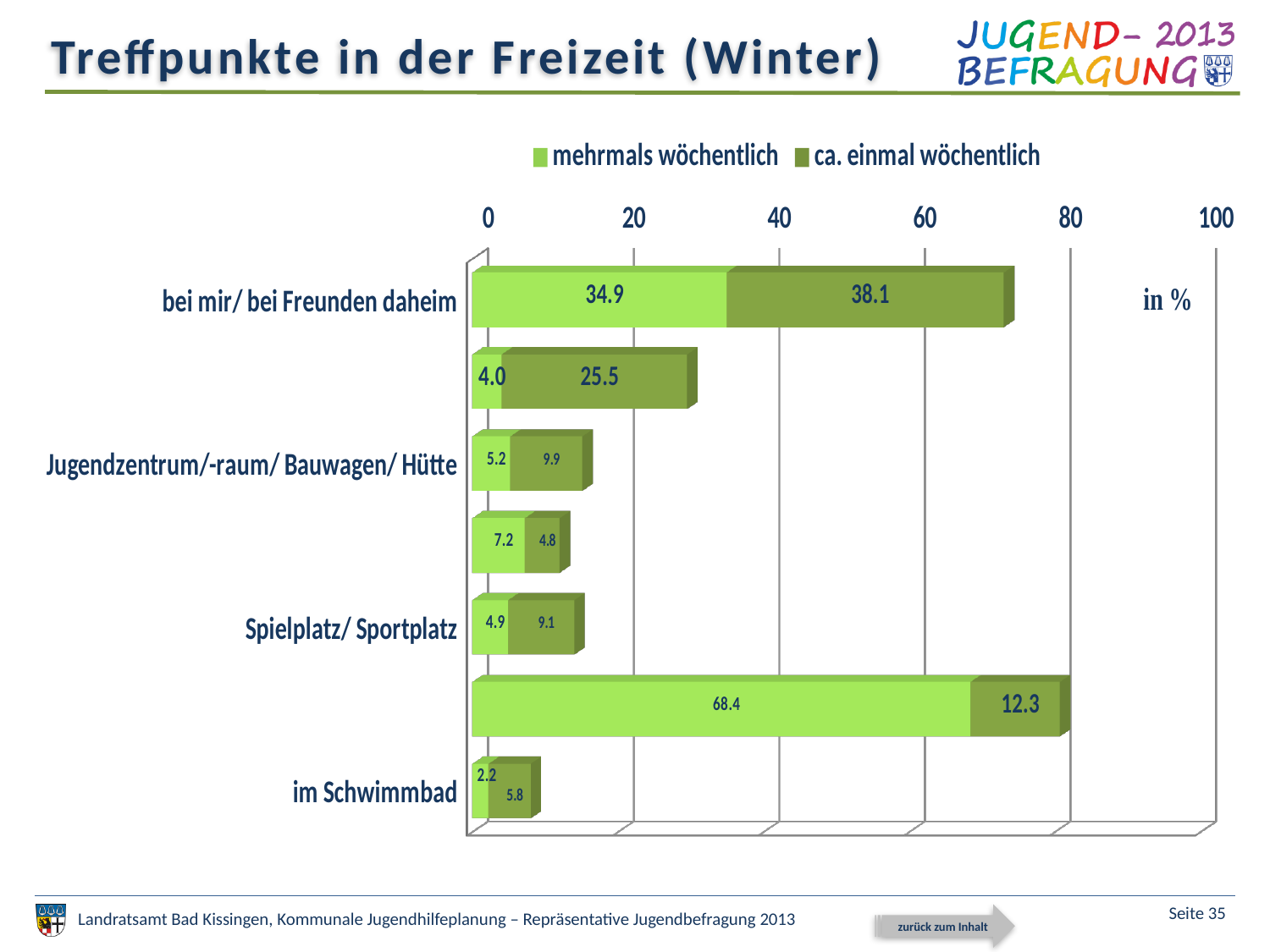
What is the value for 'ca. einmal wöchentlich' for 'Jugendzentrum/-raum/ Bauwagen/ Hütte'? 9.9 What is the title of the slide? Treffpunkte in der Freizeit (Winter) What is the value for 'mehrmals wöchentlich' for 'Spielplatz/ Sportplatz'? 4.9 What is the difference between the 'ca. einmal wöchentlich' and 'mehrmals wöchentlich' values for 'bei mir/ bei Freunden daheim'? 3.2 What is the total of the stacked bar for 'bei mir/ bei Freunden daheim'? 73.0 What kind of chart is shown on the slide? Bar chart How many series does the legend list? 2 What is the value for 'ca. einmal wöchentlich' for 'bei mir/ bei Freunden daheim'? 38.1 Which is larger for 'Spielplatz/ Sportplatz': 'mehrmals wöchentlich' or 'ca. einmal wöchentlich'? ca. einmal wöchentlich What is the value for 'ca. einmal wöchentlich' for 'im Schwimmbad'? 5.8 What is the value for 'mehrmals wöchentlich' for 'bei mir/ bei Freunden daheim'? 34.9 What is the total of the stacked bar for 'im Schwimmbad'? 8.0